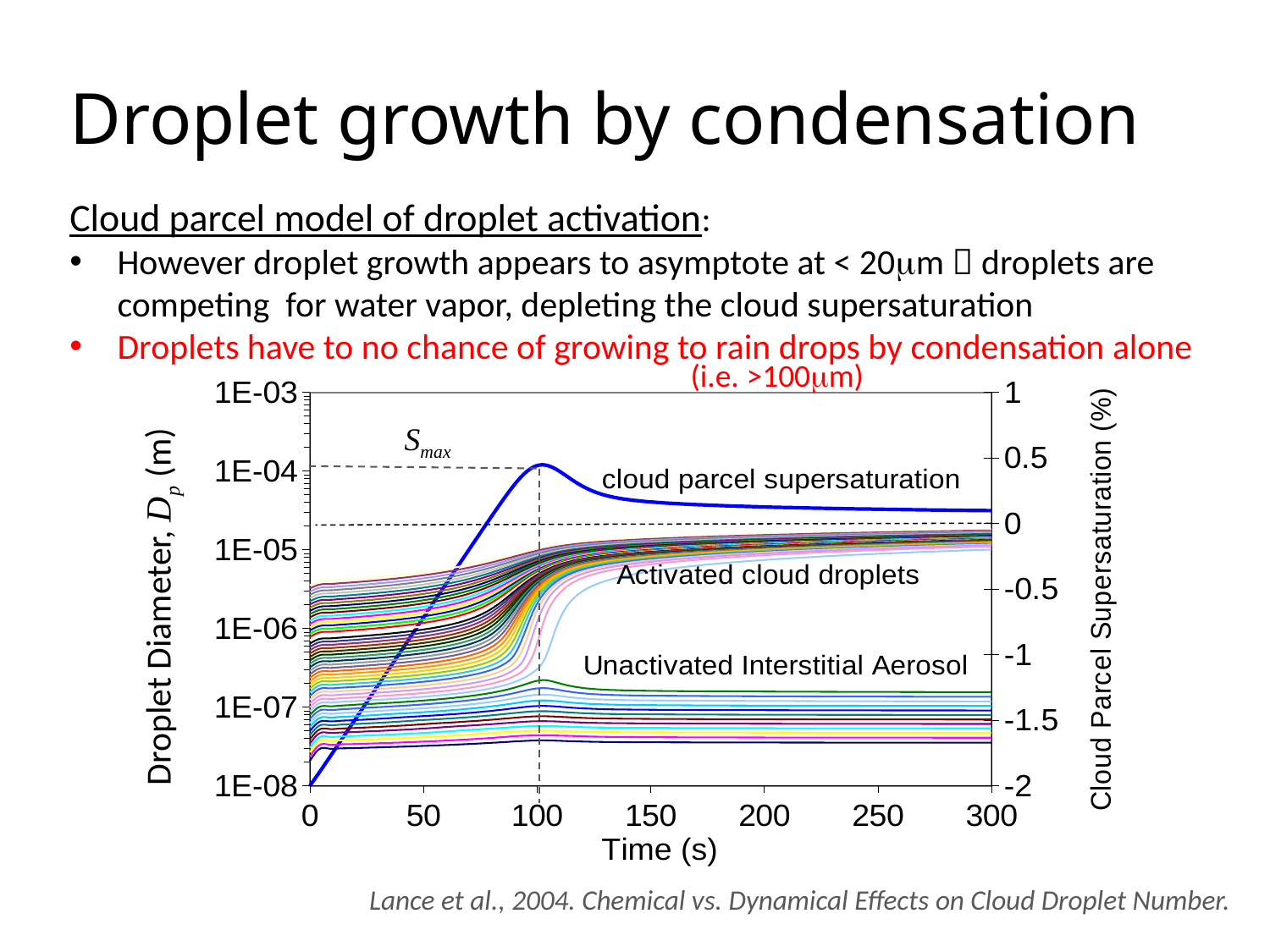
Is the cloud parcel supersaturation at 300 s greater or less than 0.5%? less Do the diameters of the activated cloud droplets rise or fall between 50 s and 150 s? rise Are the diameters of the activated cloud droplets at 300 s greater or less than 1E-06 m? greater Does the cloud parcel supersaturation rise or fall between 100 s and 300 s? fall Does the cloud parcel supersaturation rise or fall between 0 s and 100 s? rise Are the diameters of the unactivated interstitial aerosol at 300 s greater or less than 1E-06 m? less What is the label of the right-hand y axis of the chart? Cloud Parcel Supersaturation (%) At what time (s) does the cloud parcel supersaturation reach its maximum, S_max? 100 What kind of chart is shown on the slide? line chart What is the label of the x axis of the chart? Time (s) Which group has larger diameters at 300 s, the activated cloud droplets or the unactivated interstitial aerosol? Activated cloud droplets